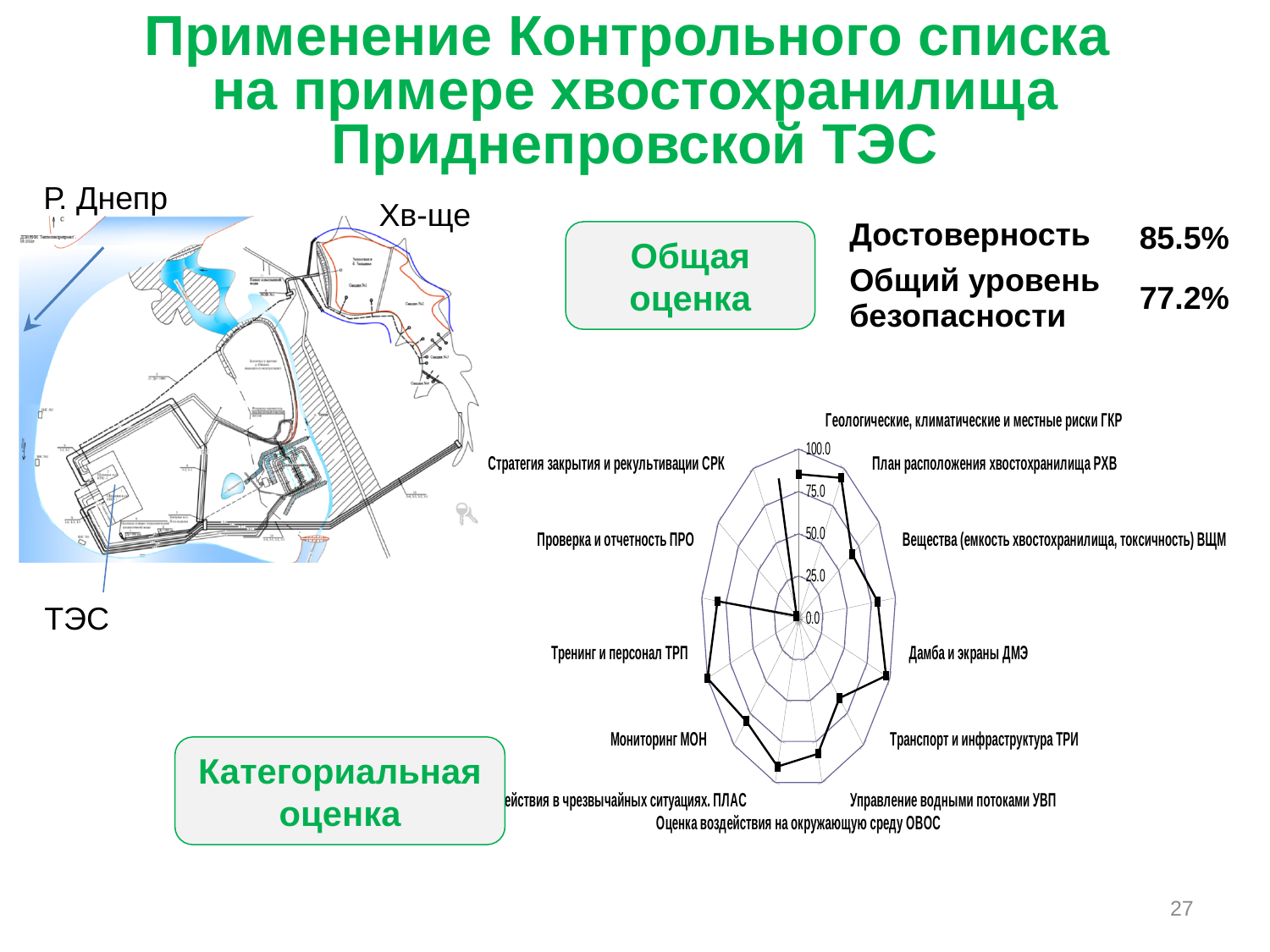
Is the value for Оценка воздействия на окружающую среду ОВОС greater or less than 75.0? greater Which category has the lowest value on the radar chart? Стратегия закрытия и рекультивации СРК Which is larger, the value for Дамба и экраны ДМЭ or the value for Тренинг и персонал ТРП? Тренинг и персонал ТРП Is the value for Дамба и экраны ДМЭ greater or less than 75.0? greater Is the value for Мониторинг МОН greater or less than 50.0? greater What is the maximum value shown on the radar chart's axis scale? 100.0 What is the interval between the tick labels on the radar chart's axis? 25.0 How many categories does the radar chart have? 12 What kind of chart is shown on the slide? radar chart